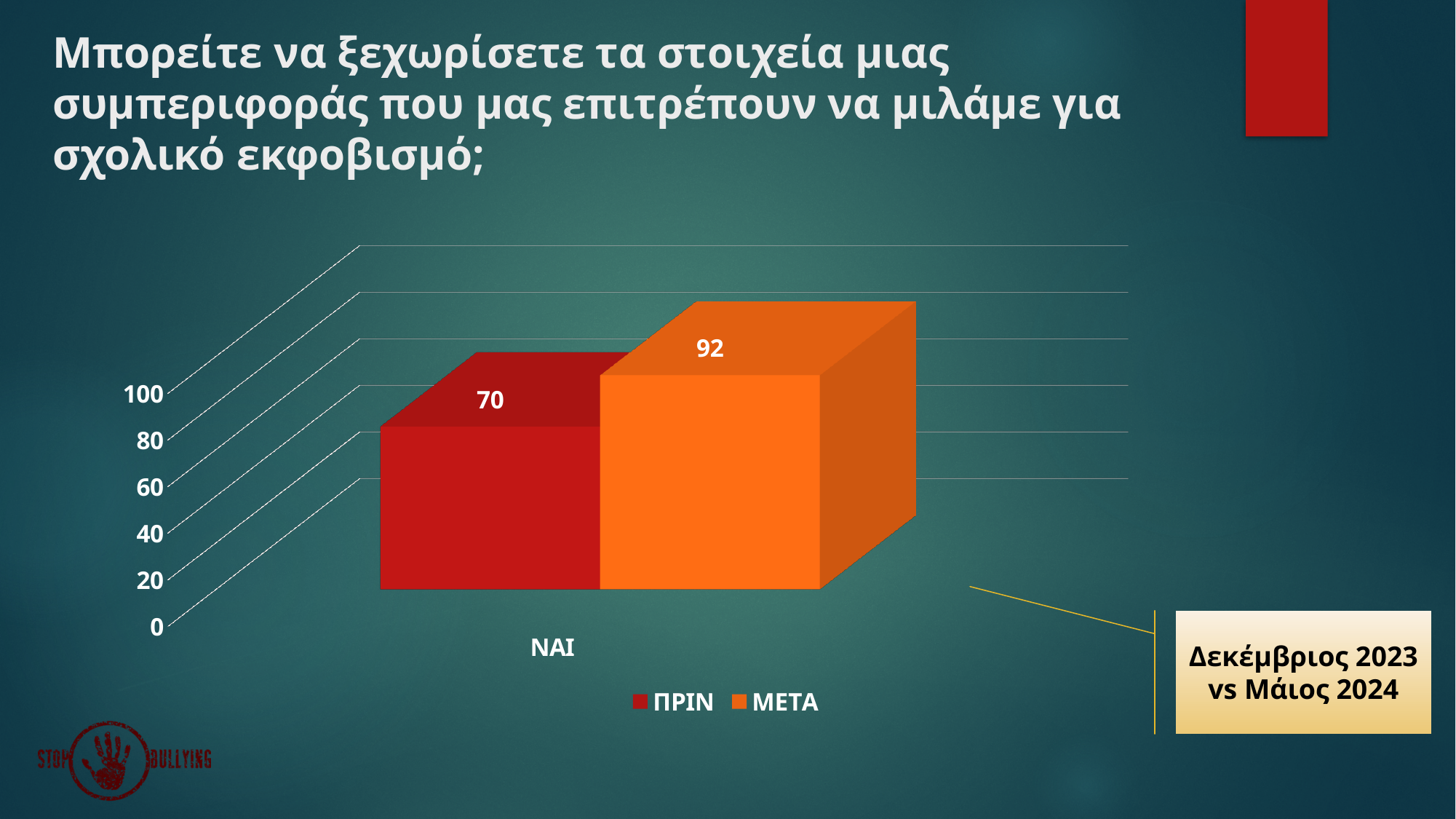
What colour is the ΜΕΤΑ series in the chart? Orange What is the difference between the ΜΕΤΑ and ΠΡΙΝ values for ΝΑΙ? 22 What is the highest value shown on the vertical axis? 100 What is the value of the ΜΕΤΑ series for the ΝΑΙ category? 92 How many categories are shown on the x axis? 1 What is the value of the ΠΡΙΝ series for the ΝΑΙ category? 70 Which series has the higher value for ΝΑΙ, ΠΡΙΝ or ΜΕΤΑ? ΜΕΤΑ What kind of chart is shown on the slide? Bar chart Is the ΜΕΤΑ value for ΝΑΙ greater or less than 80? greater How many series does the legend list? 2 What is the label of the category on the x axis? ΝΑΙ Is the ΠΡΙΝ value for ΝΑΙ greater or less than 80? less